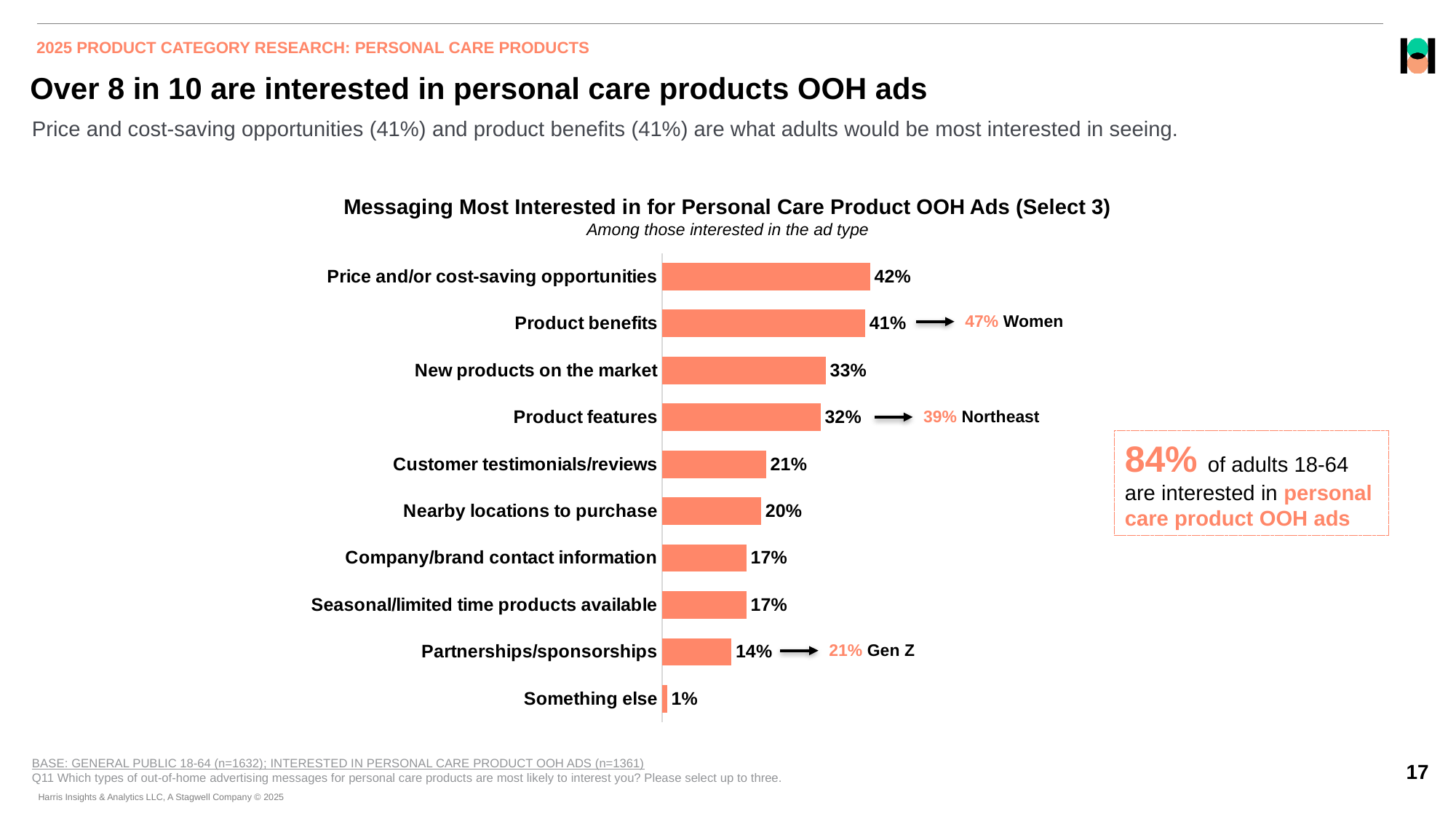
What is the difference between "Price and/or cost-saving opportunities" and "Nearby locations to purchase"? 22% What percentage is shown for "Partnerships/sponsorships"? 14% How many messaging categories are plotted in the chart? 10 Which messaging category has the highest value? Price and/or cost-saving opportunities What type of chart is shown on the slide? Bar chart What is the value for "Customer testimonials/reviews"? 21% What percentage is shown for "New products on the market"? 33% Which is larger: "New products on the market" or "Customer testimonials/reviews"? New products on the market What is the title of the chart? Messaging Most Interested in for Personal Care Product OOH Ads (Select 3) What percentage of adults 18-64 are interested in personal care product OOH ads, according to the callout box? 84% According to the callout next to "Product benefits", what percentage of women selected it? 47% Which category has the lowest value? Something else